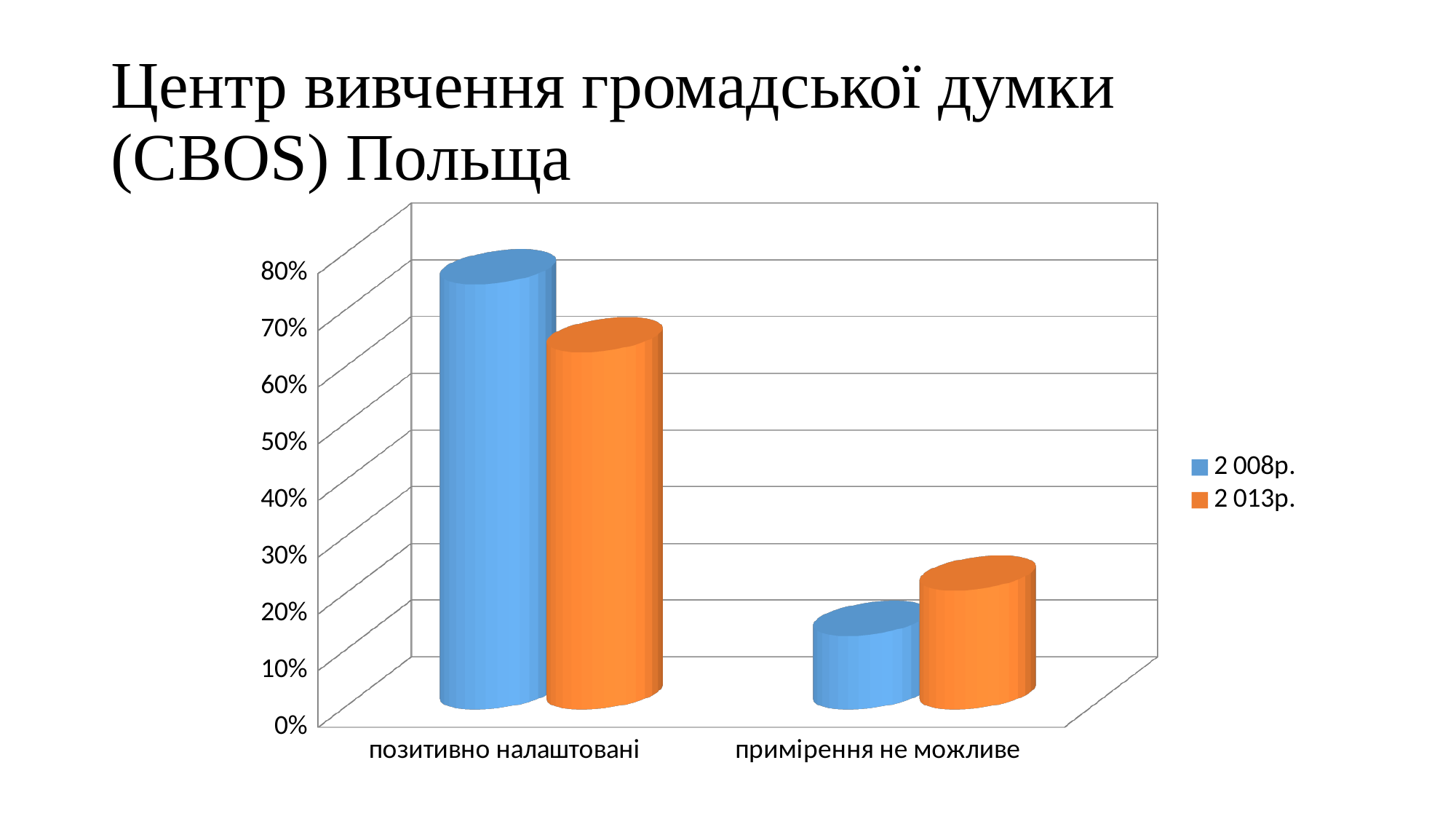
Which category and series has the highest bar in the chart? позитивно налаштовані, 2 008р. What kind of chart is shown on the slide? bar chart How many series does the legend list? 2 For the category 'примірення не можливе', which series has the larger value, 2 008р. or 2 013р.? 2 013р. Is the value for 'примірення не можливе' in 2 013р. greater or less than 40%? less Which category and series has the lowest bar in the chart? примірення не можливе, 2 008р. Is the value for 'позитивно налаштовані' in 2 013р. greater or less than 50%? greater For the category 'позитивно налаштовані', which series has the larger value, 2 008р. or 2 013р.? 2 008р. Which series does the orange colour represent in the chart? 2 013р. How many categories are shown on the x axis of the chart? 2 Is the value for 'позитивно налаштовані' in 2 008р. greater or less than 60%? greater